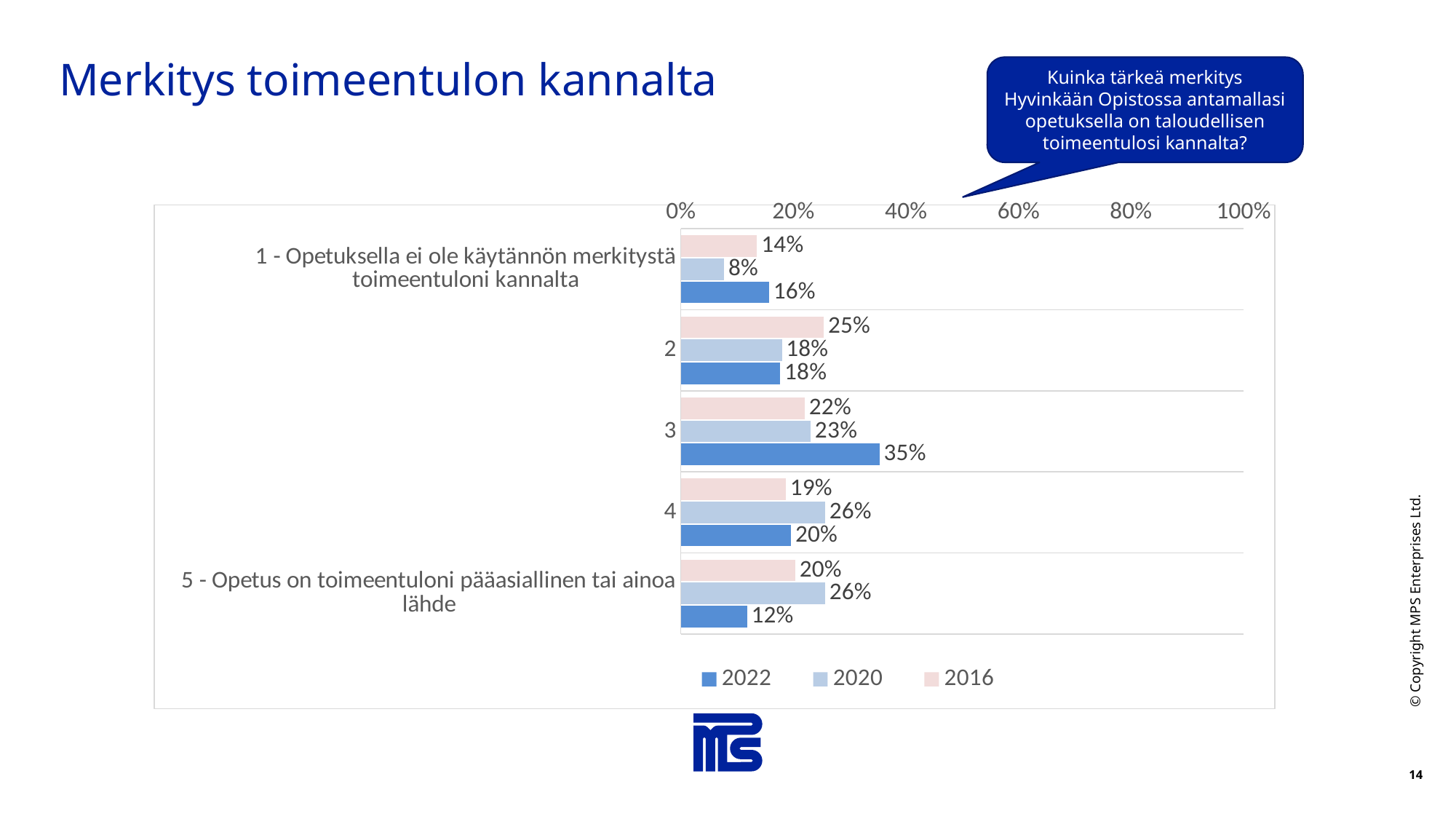
What is the 2022 value for category 3? 35% Is the 2022 value for category 3 greater or less than 20%? greater What is the difference between the 2022 and 2020 values for category 3? 12% How many series does the legend list? 3 What is the 2016 value for category 2? 25% What is the 2020 value for category "1 - Opetuksella ei ole käytännön merkitystä toimeentuloni kannalta"? 8% What is the 2022 value for category "5 - Opetus on toimeentuloni pääasiallinen tai ainoa lähde"? 12% Which category has the highest 2022 value? 3 What kind of chart is shown on the slide? Bar chart For category 5, which is larger: the 2020 value or the 2022 value? 2020 How many categories are shown on the chart? 5 Which category has the lowest 2020 value? 1 - Opetuksella ei ole käytännön merkitystä toimeentuloni kannalta